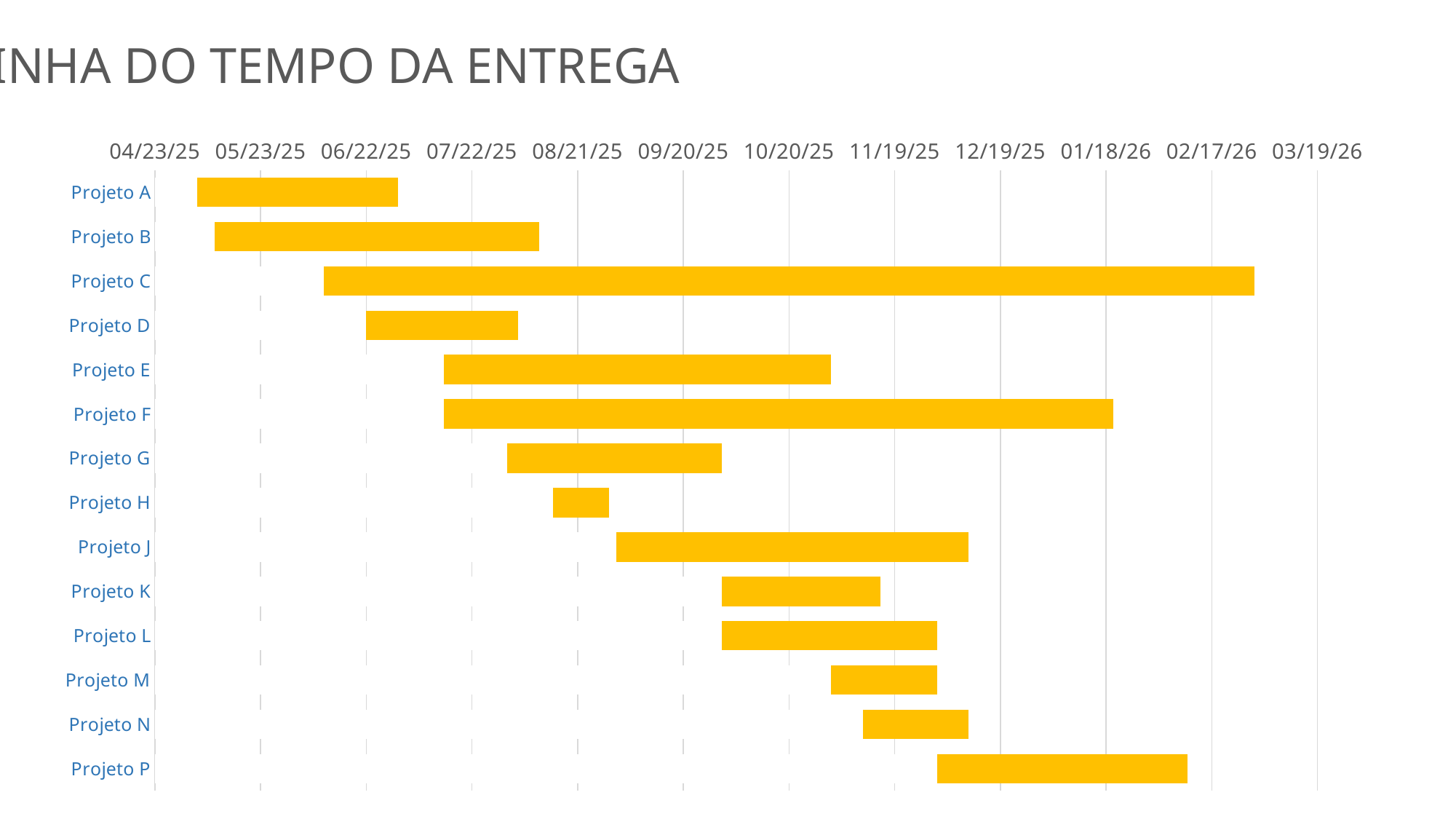
Which bar is longer, Projeto B or Projeto A? Projeto B Which bar is longer, Projeto C or Projeto D? Projeto C How many projects are listed on the vertical axis of the chart? 14 Does the bar for Projeto C end before or after the 02/17/26 tick? after What kind of chart is shown on the slide? bar chart Does the bar for Projeto P end before or after the 01/18/26 tick? after Which project has the longest bar in the chart? Projeto C Which project's bar starts earliest on the timeline? Projeto A Does the bar for Projeto A start before or after the 05/23/25 tick? before Which project has the shortest bar in the chart? Projeto H Which project's bar starts latest on the timeline? Projeto P Which project's bar ends latest on the timeline? Projeto C